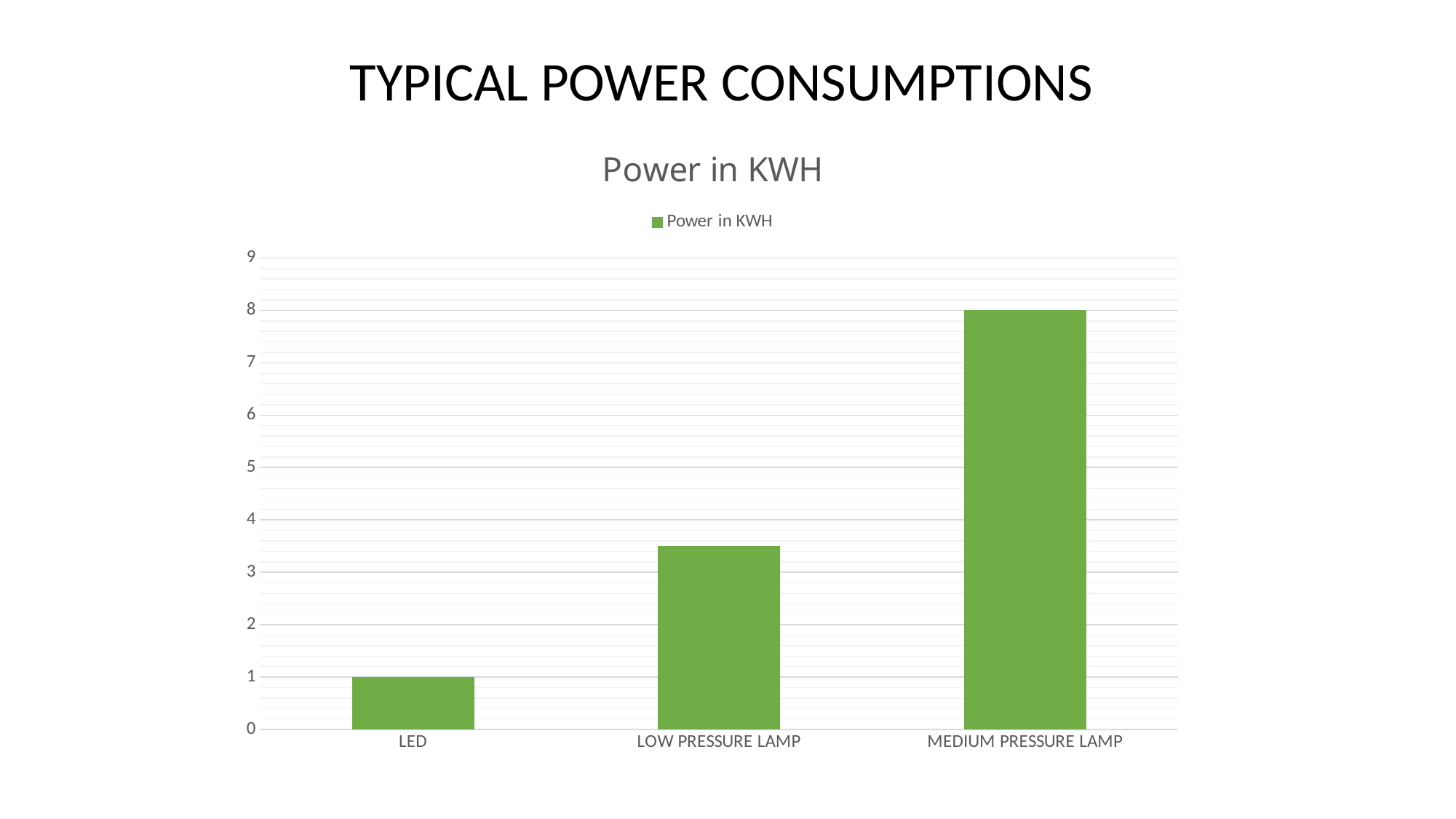
How many categories are shown on the x axis? 3 How many series does the legend list? 1 Do the values rise or fall from left to right along the x axis? rise Is the value for LOW PRESSURE LAMP greater or less than 4? less What is the value for MEDIUM PRESSURE LAMP? 8 What is the difference between the values for MEDIUM PRESSURE LAMP and LED? 7 Which category has the highest value? MEDIUM PRESSURE LAMP What is the chart title? Power in KWH Which category has the lowest value? LED What type of chart is shown on the slide? bar chart What is the value for LED? 1 Is the value for LOW PRESSURE LAMP greater or less than 3? greater